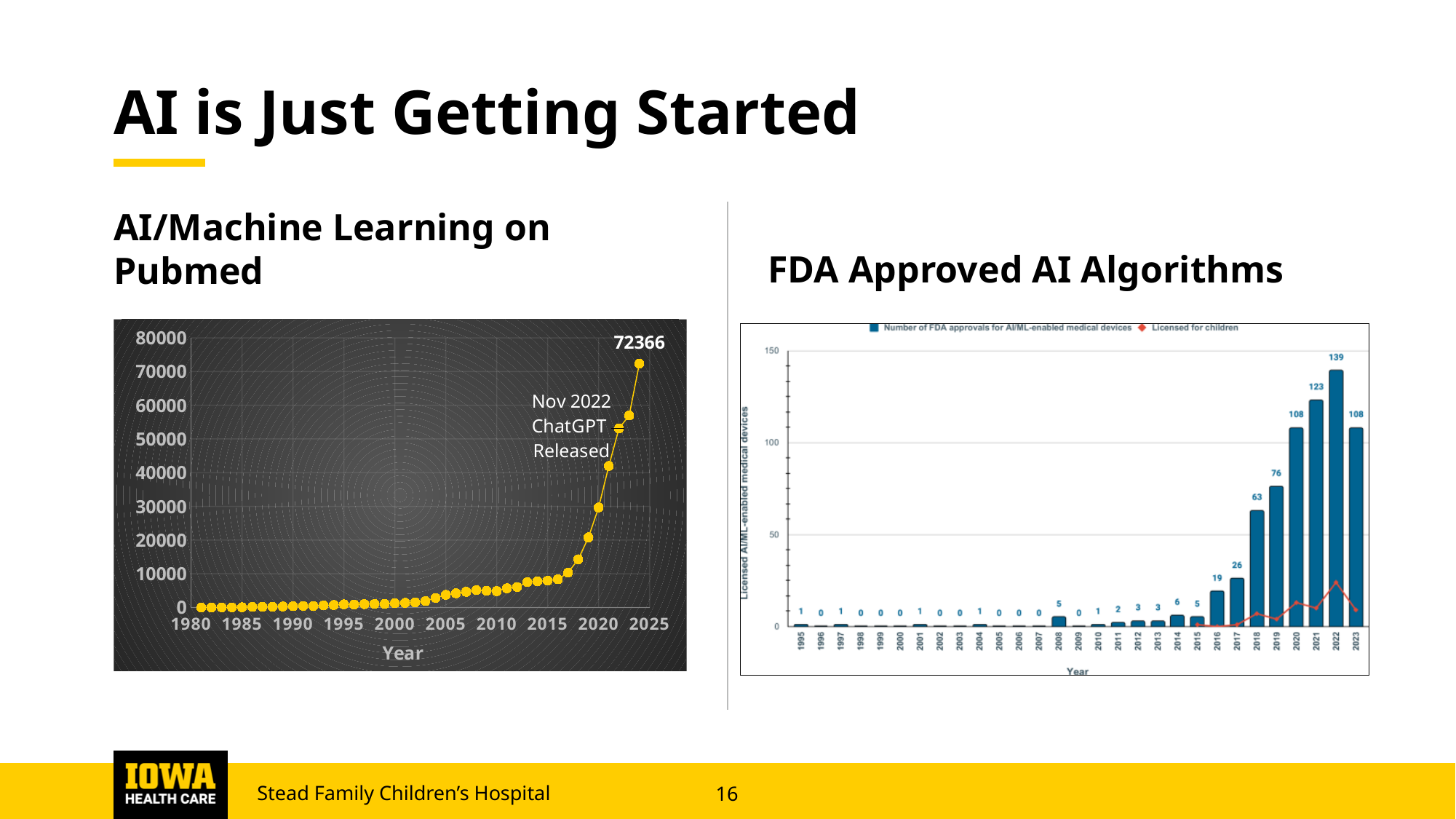
On the FDA Approved AI Algorithms chart, what is the difference between the number of approvals in 2022 and in 2023? 31 On the AI/Machine Learning on Pubmed chart, is the value for 2015 greater or less than 10000? less What is the highest value labelled on the AI/Machine Learning on Pubmed chart? 72366 On the FDA Approved AI Algorithms chart, which year had more FDA approvals, 2016 or 2017? 2017 On the FDA Approved AI Algorithms chart, what is the difference between the number of approvals in 2021 and in 2020? 15 On the FDA Approved AI Algorithms chart, how many series does the legend list? 2 On the FDA Approved AI Algorithms chart, which year has the highest number of FDA approvals? 2022 What kind of chart is the AI/Machine Learning on Pubmed chart? Line chart On the FDA Approved AI Algorithms chart, how many FDA approvals for AI/ML-enabled medical devices were there in 2022? 139 On the FDA Approved AI Algorithms chart, how many FDA approvals were there in 2018? 63 What event is annotated on the AI/Machine Learning on Pubmed chart? Nov 2022 ChatGPT Released On the FDA Approved AI Algorithms chart, how many FDA approvals were there in 2008? 5